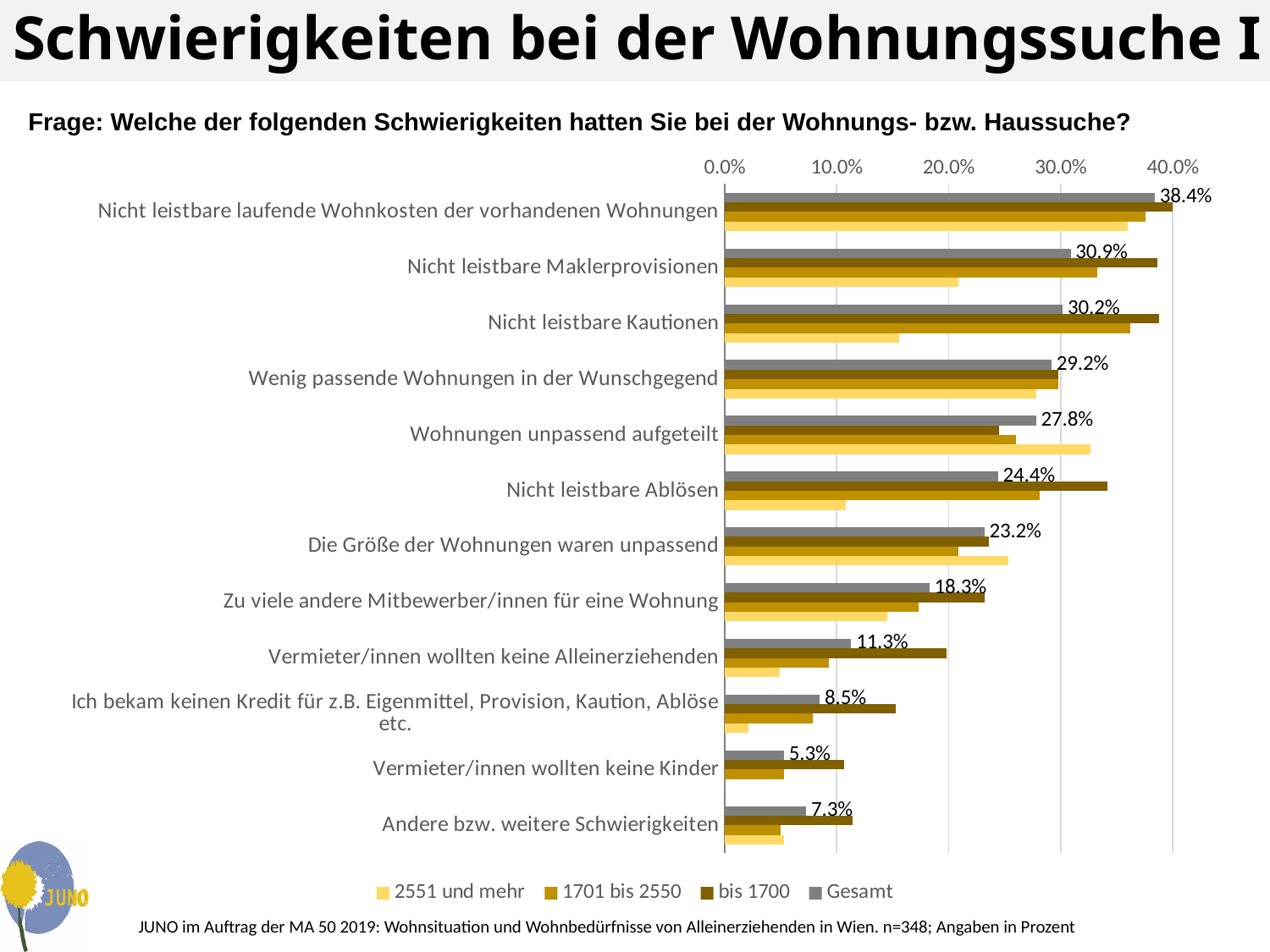
Which category has the lowest Gesamt value? Vermieter/innen wollten keine Kinder What kind of chart is shown on the slide? Bar chart How many series does the legend list? 4 Is the value of the "bis 1700" series for "Nicht leistbare Ablösen" greater or less than 30.0%? greater What is the Gesamt value for "Vermieter/innen wollten keine Alleinerziehenden"? 11.3% What is the Gesamt value for "Nicht leistbare laufende Wohnkosten der vorhandenen Wohnungen"? 38.4% Which category has the highest Gesamt value? Nicht leistbare laufende Wohnkosten der vorhandenen Wohnungen What is the difference between the Gesamt values for "Nicht leistbare Maklerprovisionen" and "Nicht leistbare Kautionen"? 0.7% Which has a larger Gesamt value: "Wohnungen unpassend aufgeteilt" or "Die Größe der Wohnungen waren unpassend"? Wohnungen unpassend aufgeteilt How many categories are shown on the chart? 12 What is the Gesamt value for "Nicht leistbare Ablösen"? 24.4% Is the value of the "2551 und mehr" series for "Nicht leistbare Kautionen" greater or less than 20.0%? less